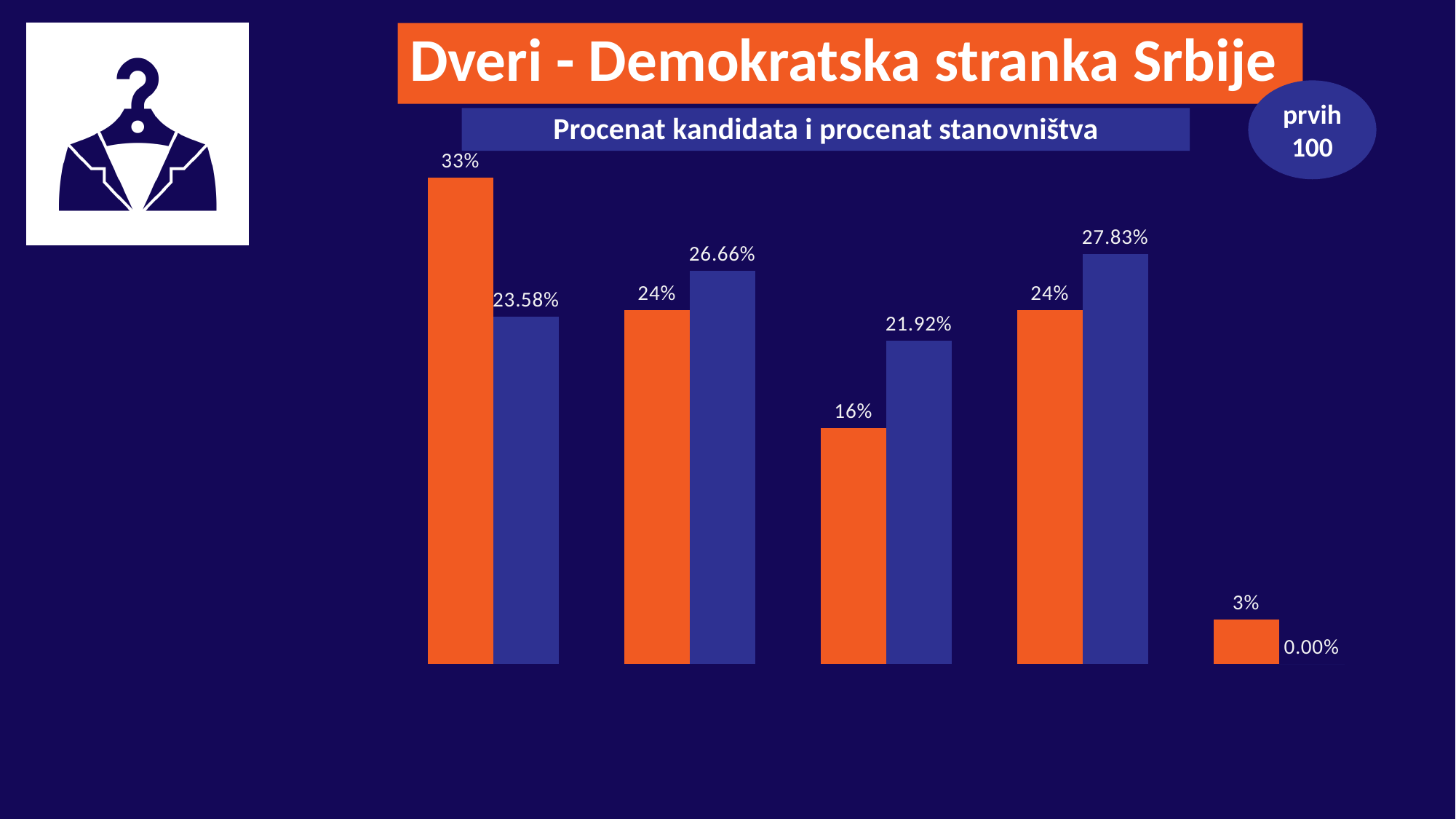
What is the title of the chart? Procenat kandidata i procenat stanovništva What is the highest value among the orange bars? 33% How many groups of bars does the chart contain? 5 What is the value of the blue bar in the third group? 21.92% In the second group, which bar is larger, the orange one or the blue one? the blue one What is the lowest value among the orange bars? 3% In the first (leftmost) group, what is the difference between the orange bar and the blue bar? 9.42% What kind of chart is shown on the slide? bar chart What is the value of the blue bar in the fifth (rightmost) group? 0.00% What is the highest value among the blue bars? 27.83% What is the value of the orange bar in the first (leftmost) group? 33% What is the value of the blue bar in the first (leftmost) group? 23.58%